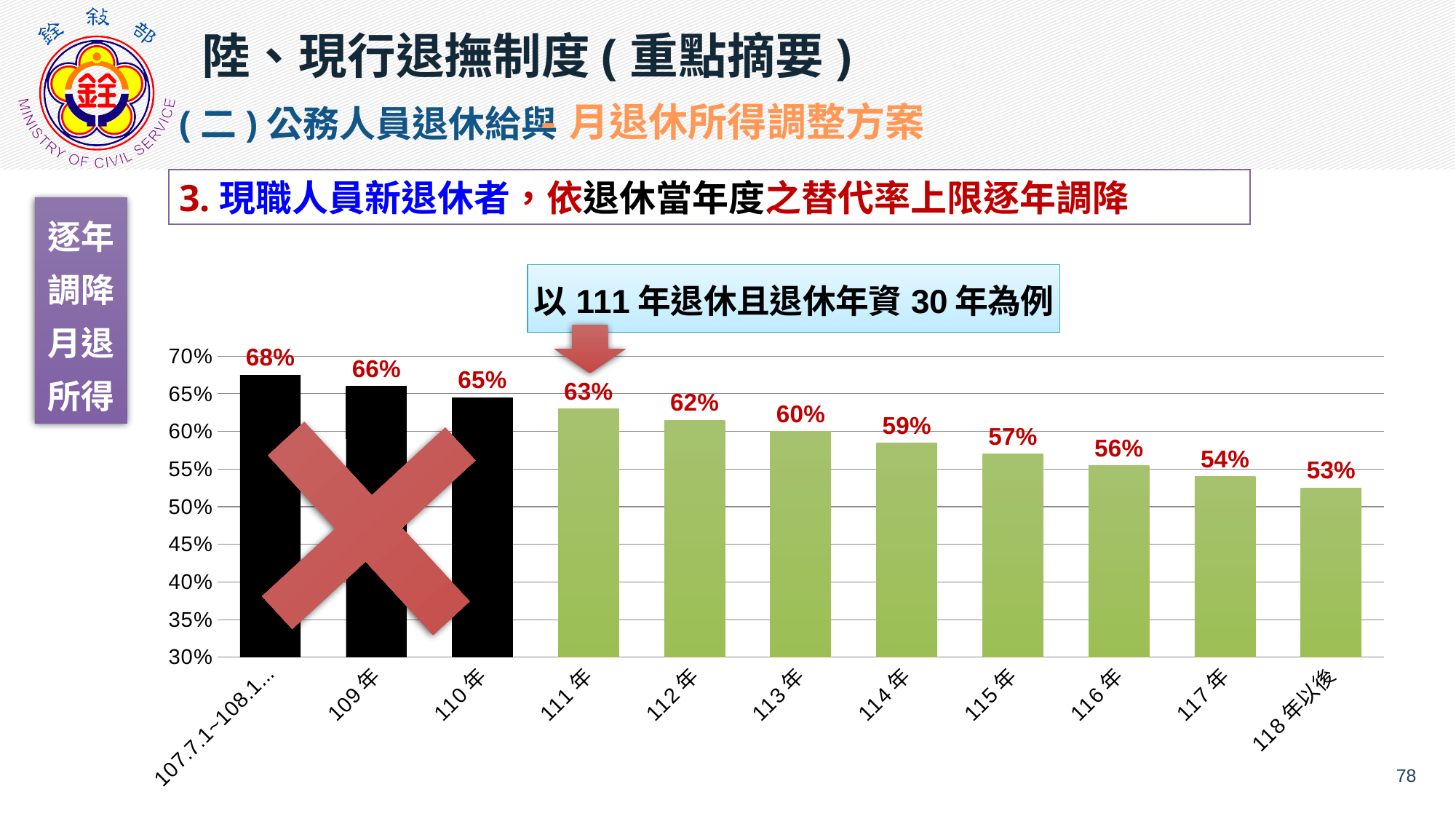
Do the values rise or fall from left to right along the x axis? fall What kind of chart is this? bar chart Which category has the highest value? 107.7.1~108.1... Which is larger, the value for 113年 or the value for 116年? 113年 What is the difference between the values for 111年 and 118年以後? 10% What is the value shown for 115年? 57% Which category has the lowest value? 118年以後 What is the value shown for 109年? 66% What is the value shown for 111年? 63% How many categories are shown on the x axis? 11 What is the difference between the values for 110年 and 111年? 2% What is the value shown for 118年以後? 53%